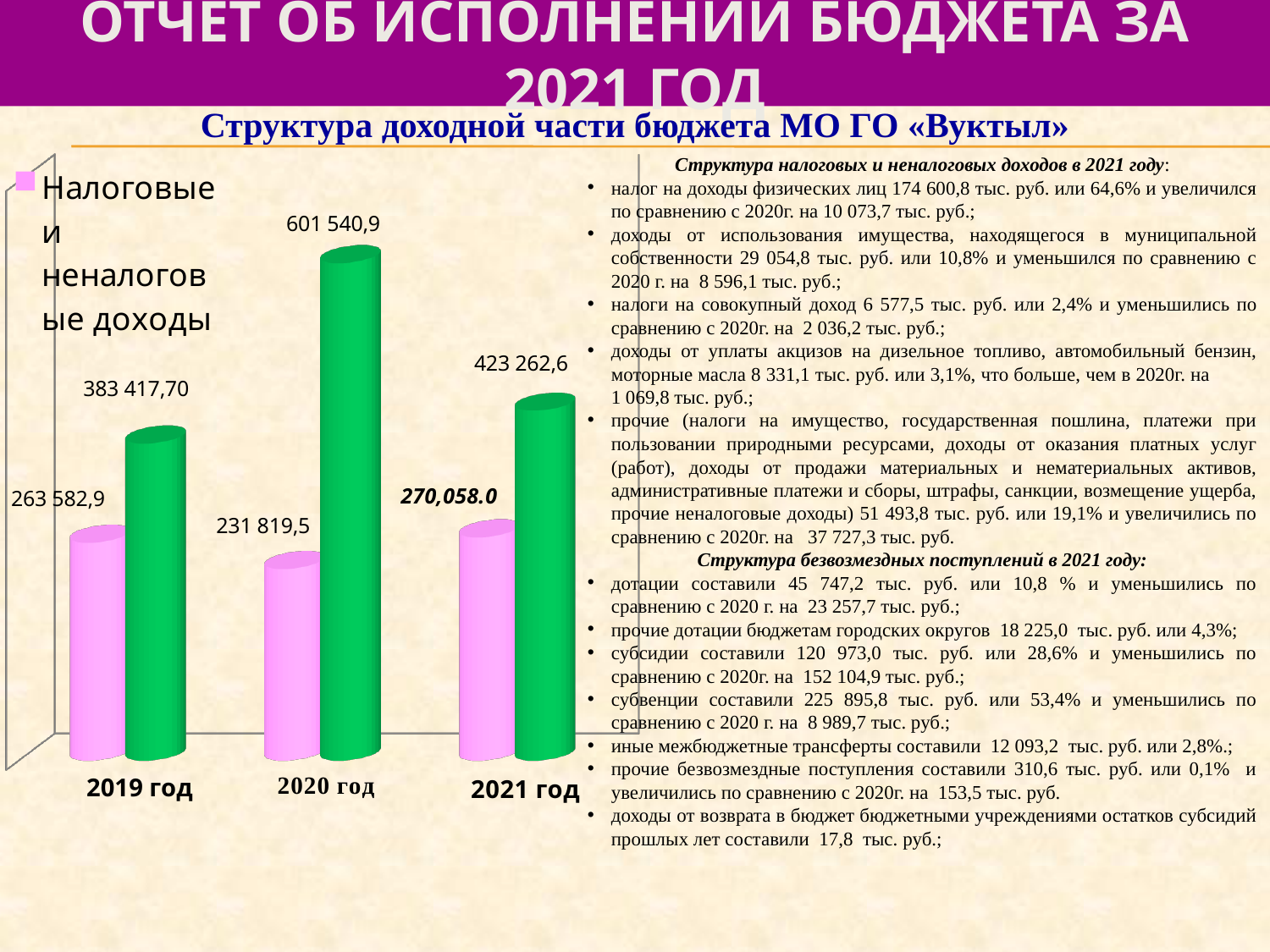
What is the value of the green bar for 2021 год? 423 262,6 What type of chart is shown on the slide? bar chart What is the value of the pink bar (Налоговые и неналоговые доходы) for 2020 год? 231 819,5 What is the value of the pink bar (Налоговые и неналоговые доходы) for 2021 год? 270,058.0 What is the value of the green bar for 2019 год? 383 417,70 For 2021 год, which bar is larger, the pink one or the green one? the green one How many years (categories) are shown on the x axis of the chart? 3 What is the value of the pink bar (Налоговые и неналоговые доходы) for 2019 год? 263 582,9 In which year is the green bar the highest? 2020 год By how much does the green bar for 2020 год exceed the green bar for 2019 год? 218 123,2 What is the value of the green bar for 2020 год? 601 540,9 In which year is the pink bar (Налоговые и неналоговые доходы) the lowest? 2020 год